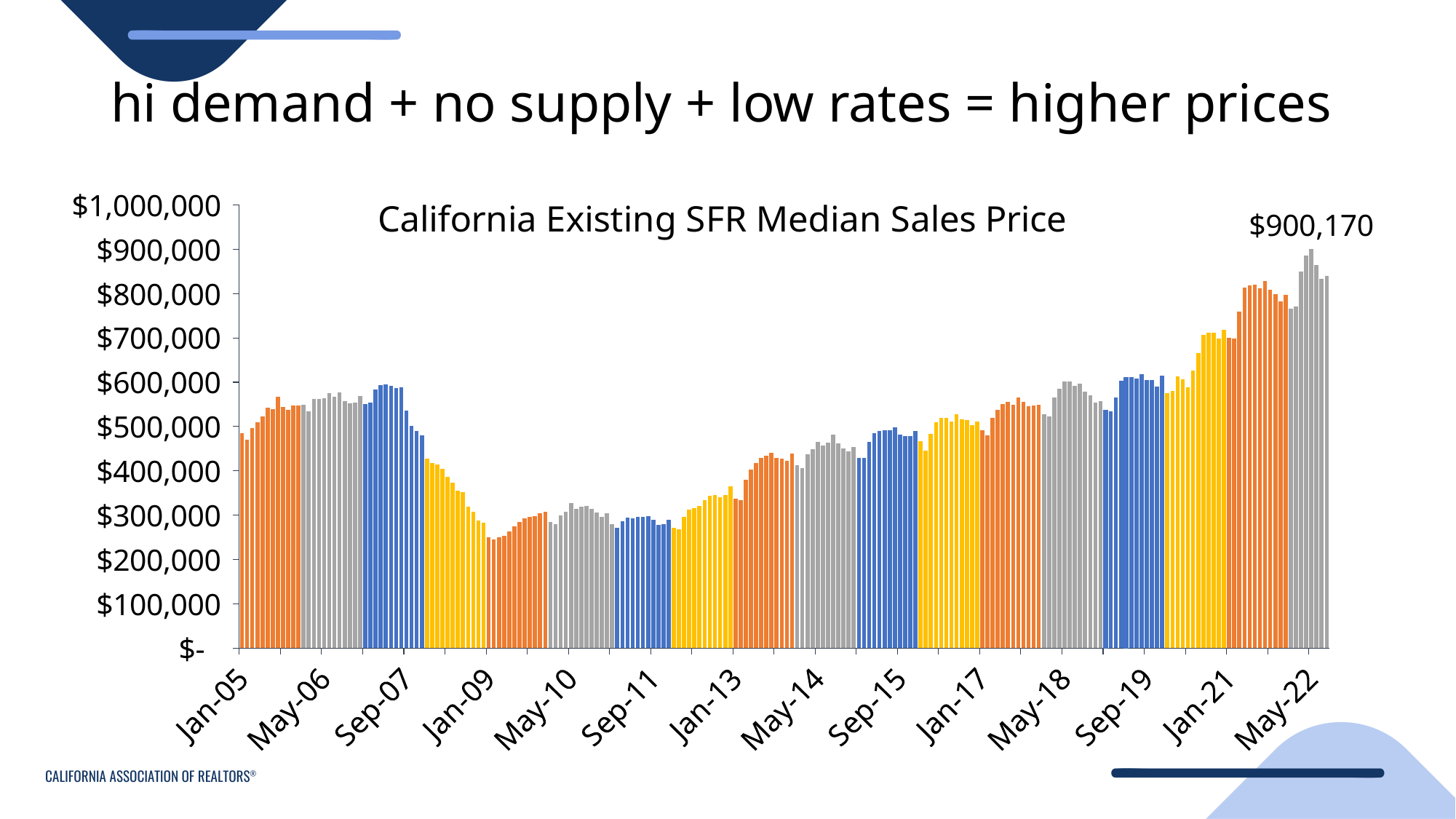
Is the value for Jan-09 greater or less than $400,000? less What is the value printed as a data label at the peak of the chart? $900,170 Is the value for Jan-05 greater or less than $400,000? greater Is the highest value on the chart greater or less than $900,000? greater Which has the larger value, Sep-07 or Jan-09? Sep-07 What kind of chart is shown on the slide? bar chart Do the values rise or fall between Sep-07 and Jan-09? fall What is the highest tick shown on the y axis? $1,000,000 What is the title of the chart? California Existing SFR Median Sales Price